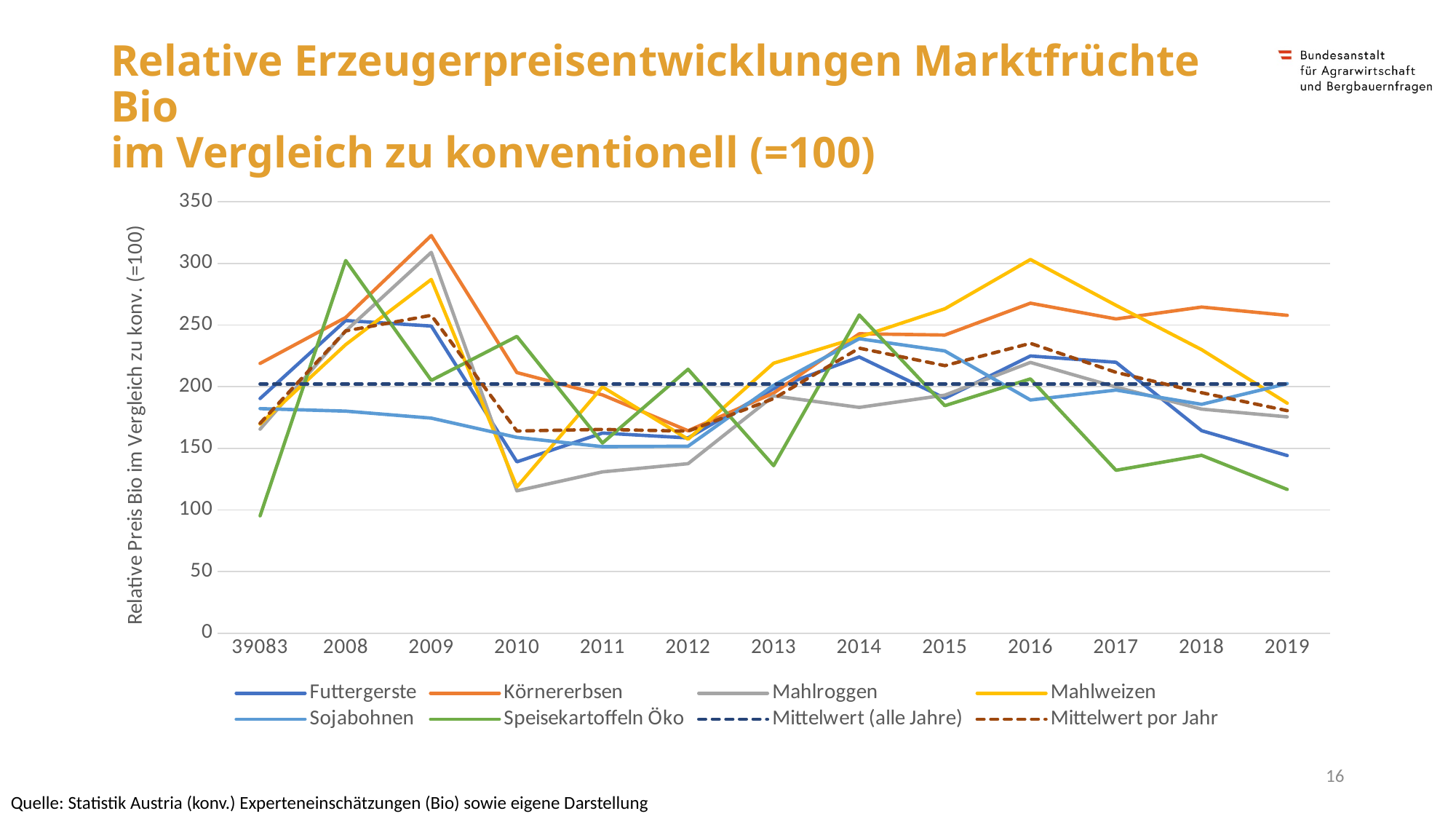
Does the value for Futtergerste rise or fall from 2016 to 2019? fall In 2010, which is larger: Speisekartoffeln Öko or Futtergerste? Speisekartoffeln Öko Is the value for Mahlroggen in 2010 greater or less than 150? less Is the value for Körnererbsen in 2009 greater or less than 300? greater In which year does Körnererbsen reach its highest value? 2009 In which year does Mahlweizen reach its highest value? 2016 How many points are shown along the x axis? 13 Which series is drawn in green? Speisekartoffeln Öko What kind of chart is shown on the slide? line chart How many series does the legend list? 8 Which series has the highest value in 2016? Mahlweizen Which series has the lowest value in 2019? Speisekartoffeln Öko